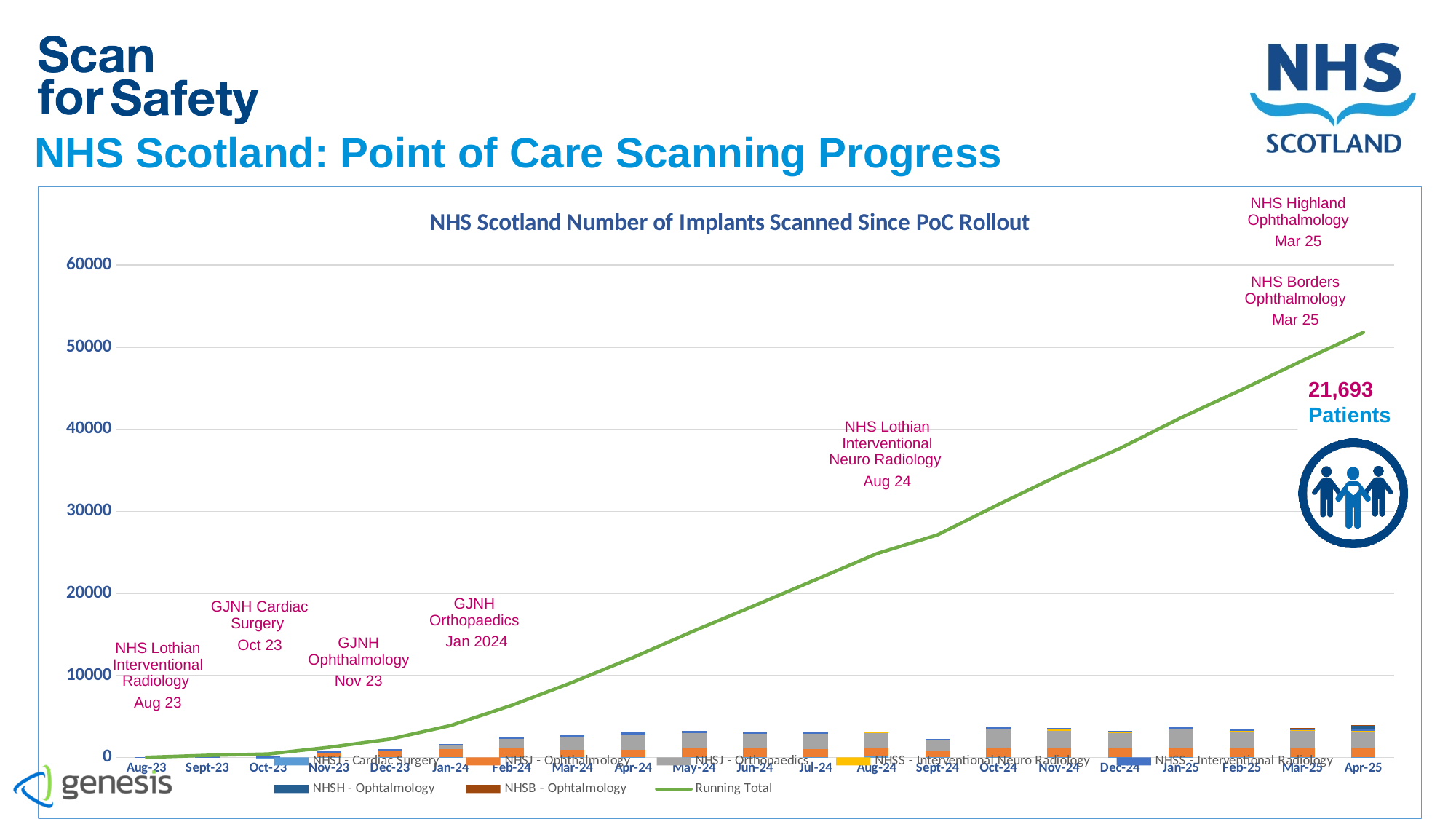
In which month is the Running Total highest? Apr-25 Which series is drawn as a green line on the chart? Running Total What is the title of the chart? NHS Scotland Number of Implants Scanned Since PoC Rollout Is the Running Total for Apr-25 greater or less than 50000? greater Is the Running Total for Jan-24 greater or less than 10000? less Is the Running Total for Nov-24 greater or less than 30000? greater In which month is the Running Total lowest? Aug-23 How many months are shown along the x axis of the chart? 21 What kind of chart is shown on the slide? Combined stacked bar and line chart How many series does the chart legend list? 8 Does the Running Total line rise or fall from Aug-23 to Apr-25? Rises Which is larger, the Running Total for Aug-24 or for Feb-24? Aug-24